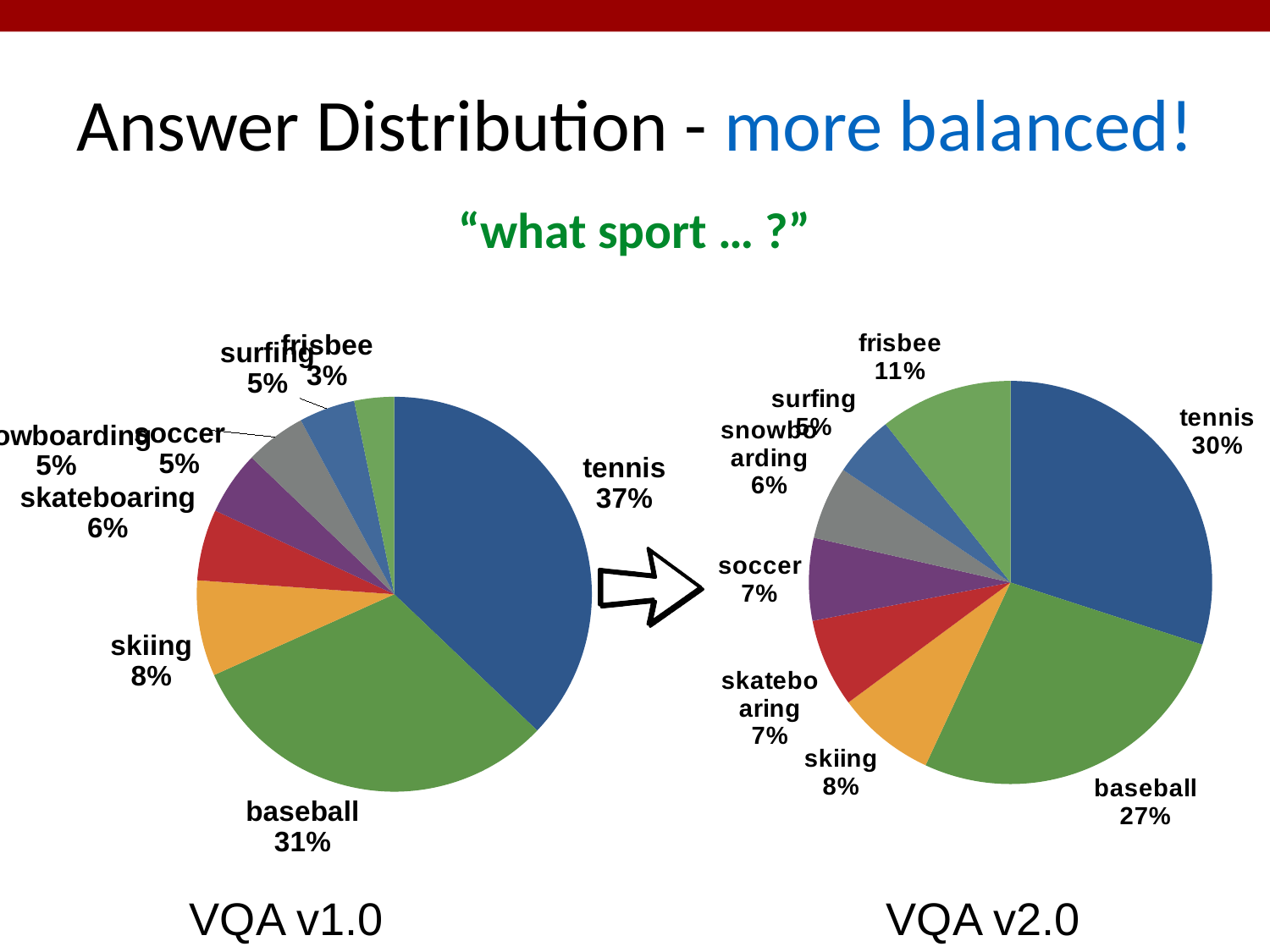
In the VQA v1.0 pie chart, which sport has the smallest share? frisbee What is the difference between the tennis share in VQA v1.0 and the tennis share in VQA v2.0? 7% In the VQA v2.0 pie chart, which sport has the smallest share? surfing Which is larger: the frisbee share in VQA v1.0 or the frisbee share in VQA v2.0? VQA v2.0 What type of chart is used for the VQA v1.0 answer distribution? pie chart In the VQA v1.0 pie chart, what is the difference between the tennis and baseball shares? 6% In the VQA v2.0 pie chart, what share does frisbee have? 11% In the VQA v1.0 pie chart, which sport has the largest share? tennis In the VQA v1.0 pie chart, what share does tennis have? 37% In the VQA v2.0 pie chart, what share does baseball have? 27% How many sports are shown in the VQA v2.0 pie chart? 8 In the VQA v2.0 pie chart, which sport has the largest share? tennis